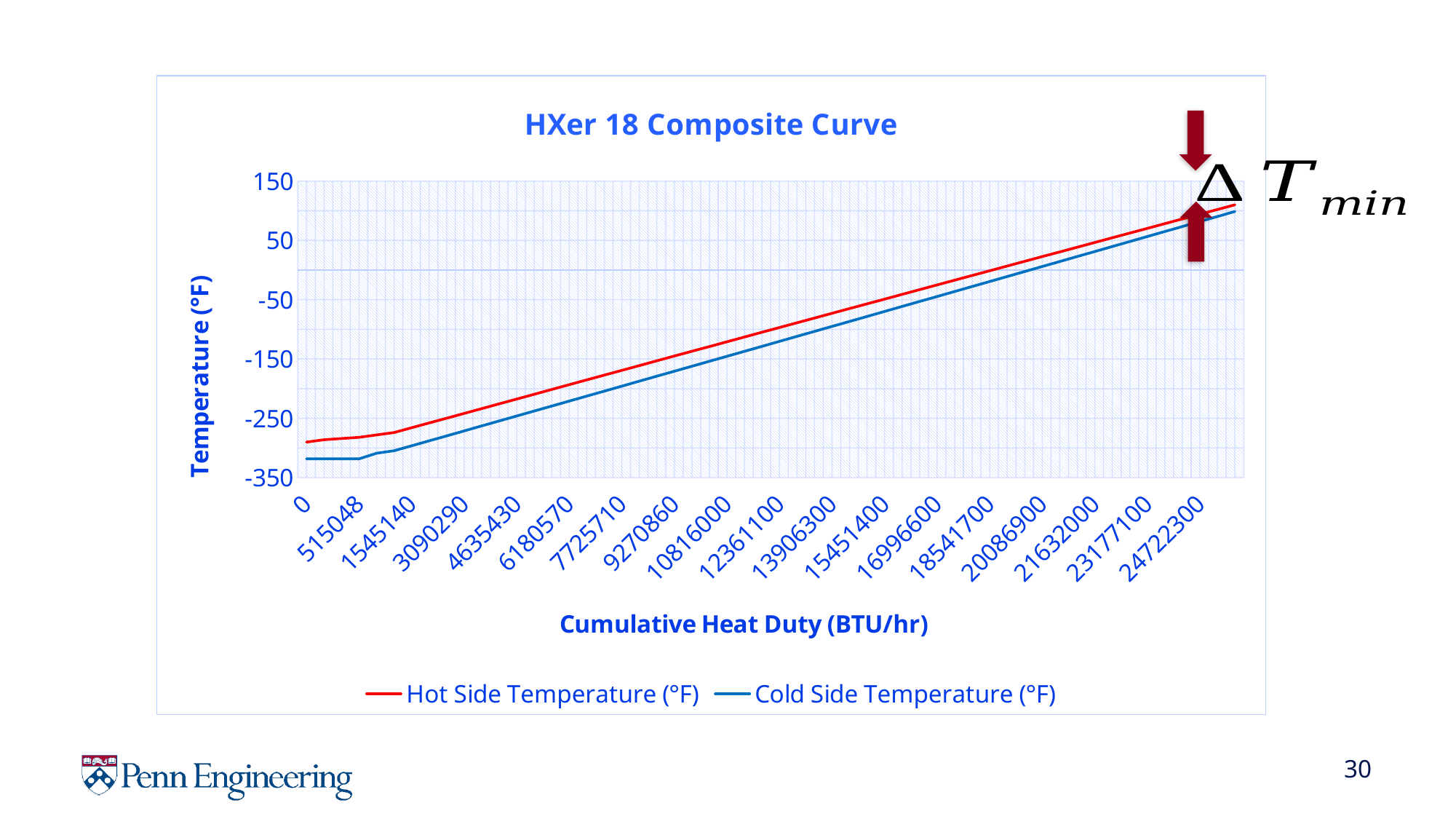
Which series is drawn in red? Hot Side Temperature (°F) What is the title of the chart? HXer 18 Composite Curve Does the Cold Side Temperature (°F) series rise or fall along the x axis? Rise Is the Hot Side Temperature (°F) at a Cumulative Heat Duty of 0 greater or less than -250? less How many series does the legend list? 2 What kind of chart is shown on the slide? Line chart Is the Cold Side Temperature (°F) at a Cumulative Heat Duty of 0 greater or less than -250? less At a Cumulative Heat Duty of 0, which series has the higher temperature, Hot Side Temperature (°F) or Cold Side Temperature (°F)? Hot Side Temperature (°F) Is the Hot Side Temperature (°F) at the right end of the chart (Cumulative Heat Duty of 24722300) greater or less than 50? greater Does the Hot Side Temperature (°F) series rise or fall as Cumulative Heat Duty increases? Rise What is the label of the x axis? Cumulative Heat Duty (BTU/hr)